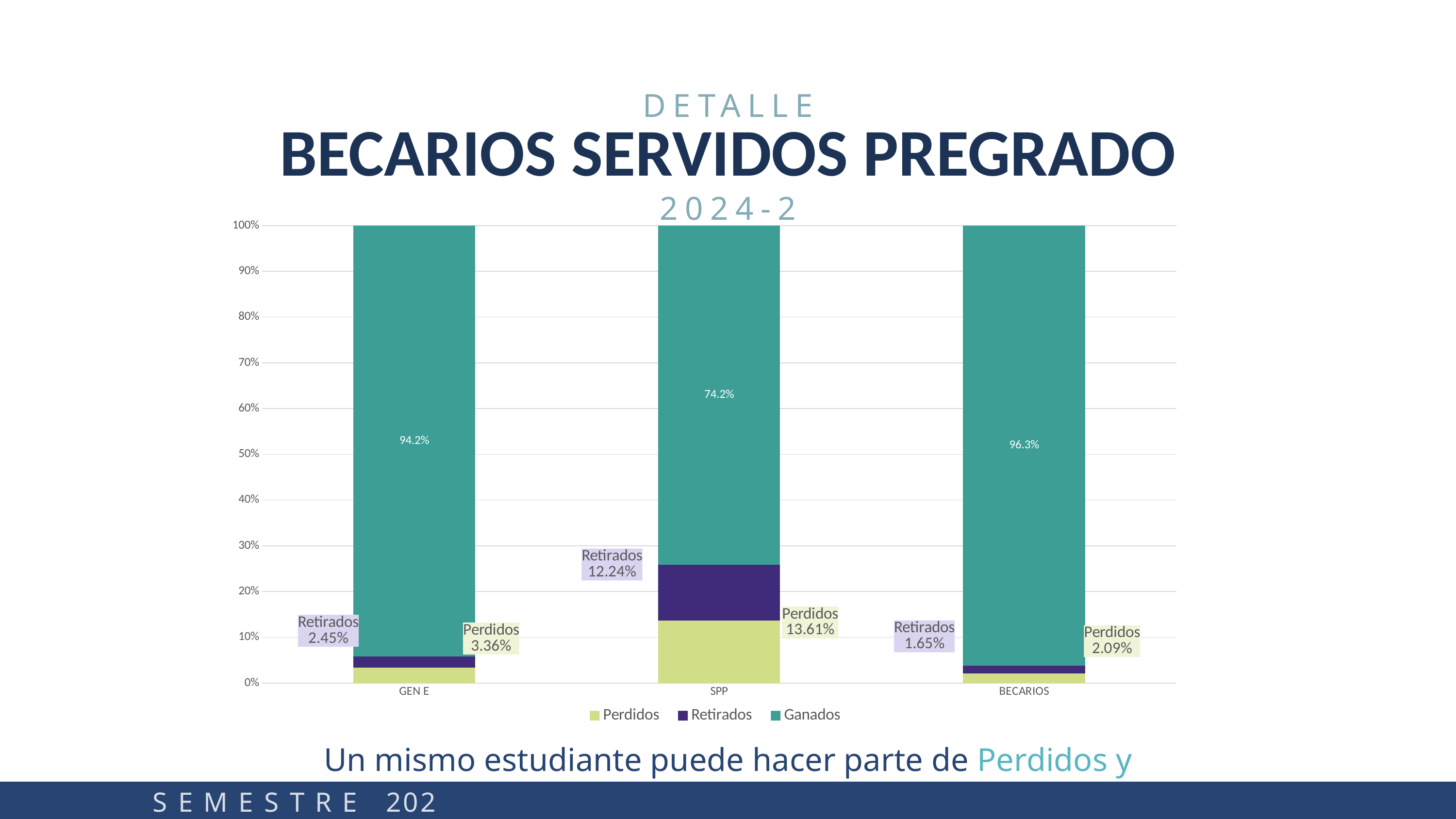
What is the Perdidos value for SPP? 13.61% What is the Retirados value for GEN E? 2.45% Is the Retirados value for SPP larger than the Retirados value for BECARIOS? Yes How many categories are shown on the x axis? 3 What is the difference between the Ganados values for BECARIOS and GEN E? 2.1% Which category has the lowest Ganados value? SPP What is the Ganados value for SPP? 74.2% Which category has the highest Ganados value? BECARIOS What is the Perdidos value for BECARIOS? 2.09% Which category has the highest Retirados value? SPP How many series does the legend list? 3 What type of chart is shown on the slide? Stacked bar chart